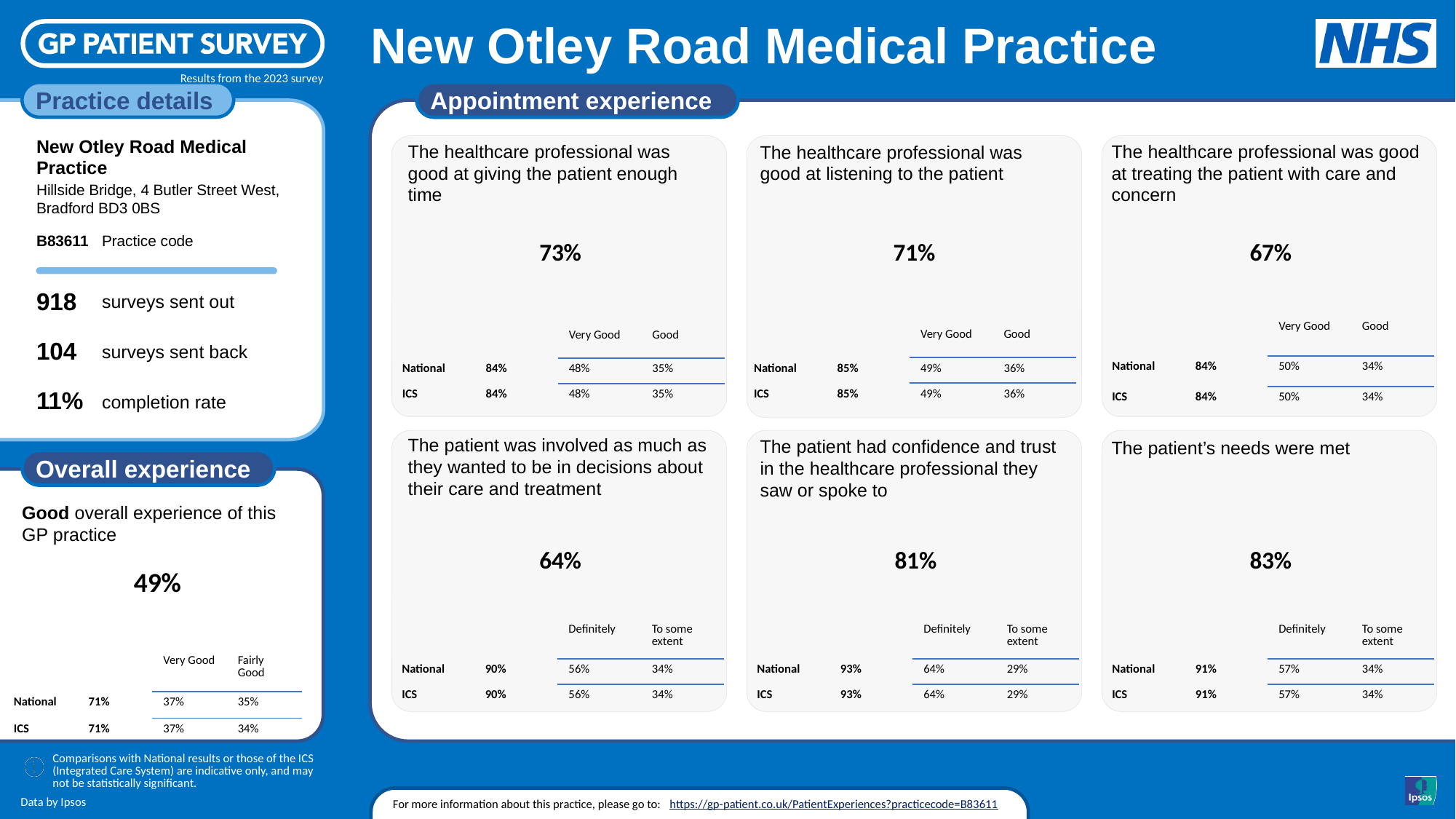
In the 'Overall experience' panel, what is the National value for good overall experience? 71% How many question panels are shown in the 'Appointment experience' section? 6 In the 'Overall experience' panel, what percentage of patients reported a good overall experience of this GP practice? 49% Among the six 'Appointment experience' panels, which question has the lowest practice headline percentage? The patient was involved as much as they wanted to be in decisions about their care and treatment In the panel 'The patient was involved as much as they wanted to be in decisions about their care and treatment', what are the two response categories listed in the comparison table? Definitely, To some extent Among the six 'Appointment experience' panels, which question has the highest practice headline percentage? The patient's needs were met In the 'Overall experience' panel, what is the ICS 'Fairly Good' value? 34% In the panel 'The patient had confidence and trust in the healthcare professional they saw or spoke to', which is larger: the practice's headline percentage or the National value? National In the panel 'The healthcare professional was good at giving the patient enough time', what is the practice's headline percentage? 73% In the panel 'The healthcare professional was good at listening to the patient', what is the National 'Very Good' value? 49% In the panel 'The healthcare professional was good at treating the patient with care and concern', what is the difference between the National value and the practice's headline percentage? 17% In the panel 'The patient's needs were met', what is the ICS 'To some extent' value? 34%